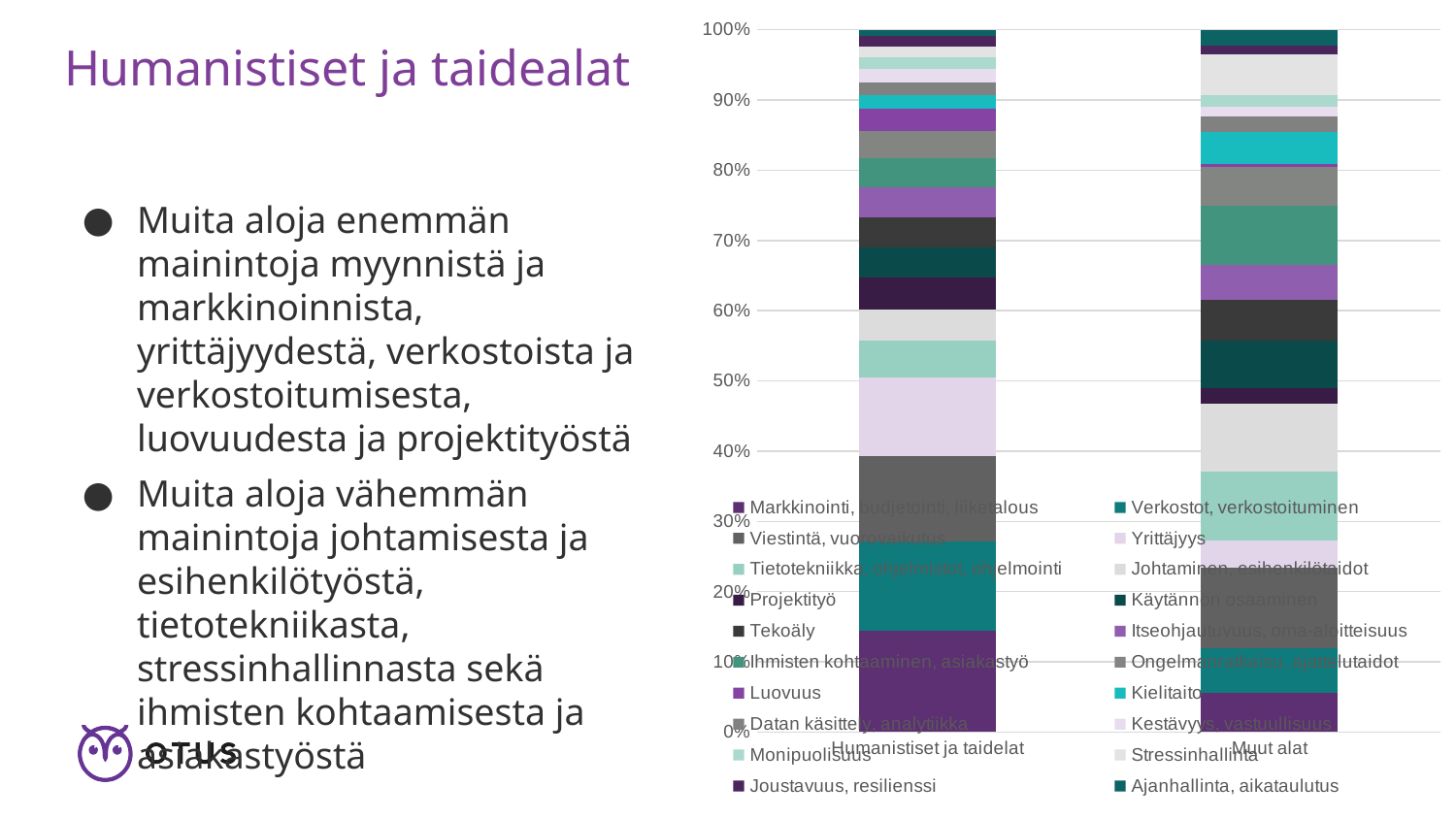
How many categories are shown on the x axis of the chart? 2 What value does each stacked bar in the chart total? 100% Is the share of 'Markkinointi, budjetointi, liiketalous' for Muut alat greater or less than 10%? less What kind of chart is shown on the slide? Stacked bar chart How many series does the chart's legend list? 20 Which category has the larger share for 'Stressinhallinta', Humanistiset ja taidealat or Muut alat? Muut alat What are the two categories on the x axis of the chart? Humanistiset ja taidelat; Muut alat Is the share of 'Markkinointi, budjetointi, liiketalous' for Humanistiset ja taidealat greater or less than 10%? greater Which category has the larger share for 'Yrittäjyys', Humanistiset ja taidealat or Muut alat? Humanistiset ja taidealat Which category has the larger share for 'Markkinointi, budjetointi, liiketalous', Humanistiset ja taidealat or Muut alat? Humanistiset ja taidealat